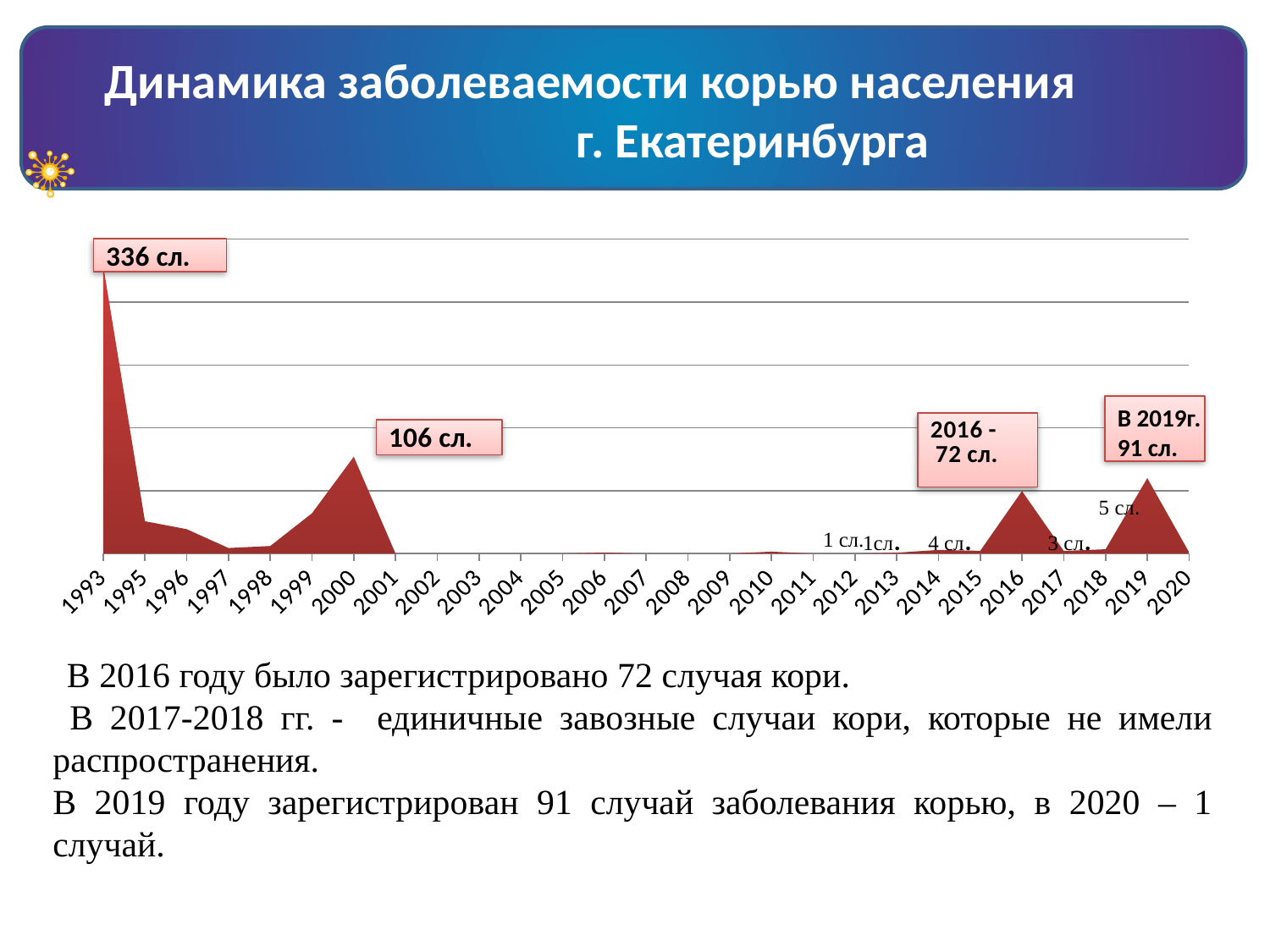
What is the title of the slide containing the chart? Динамика заболеваемости корью населения г. Екатеринбурга Which year has the highest number of measles cases on the chart? 1993 Which year had more cases, 2016 or 2019? 2019 How many measles cases are labelled for 1993? 336 сл. How many cases does the chart label for 2016? 72 сл. What is the difference between the labelled cases in 1993 and in 2000? 230 What type of chart is shown on the slide? Area chart How many cases does the chart label for 2019? 91 сл. Which year had more cases, 1993 or 2000? 1993 What value is labelled for the year 2000? 106 сл. By how many cases does the 2019 value exceed the 2016 value? 19 Do the values rise or fall from 1993 to 1997? Fall